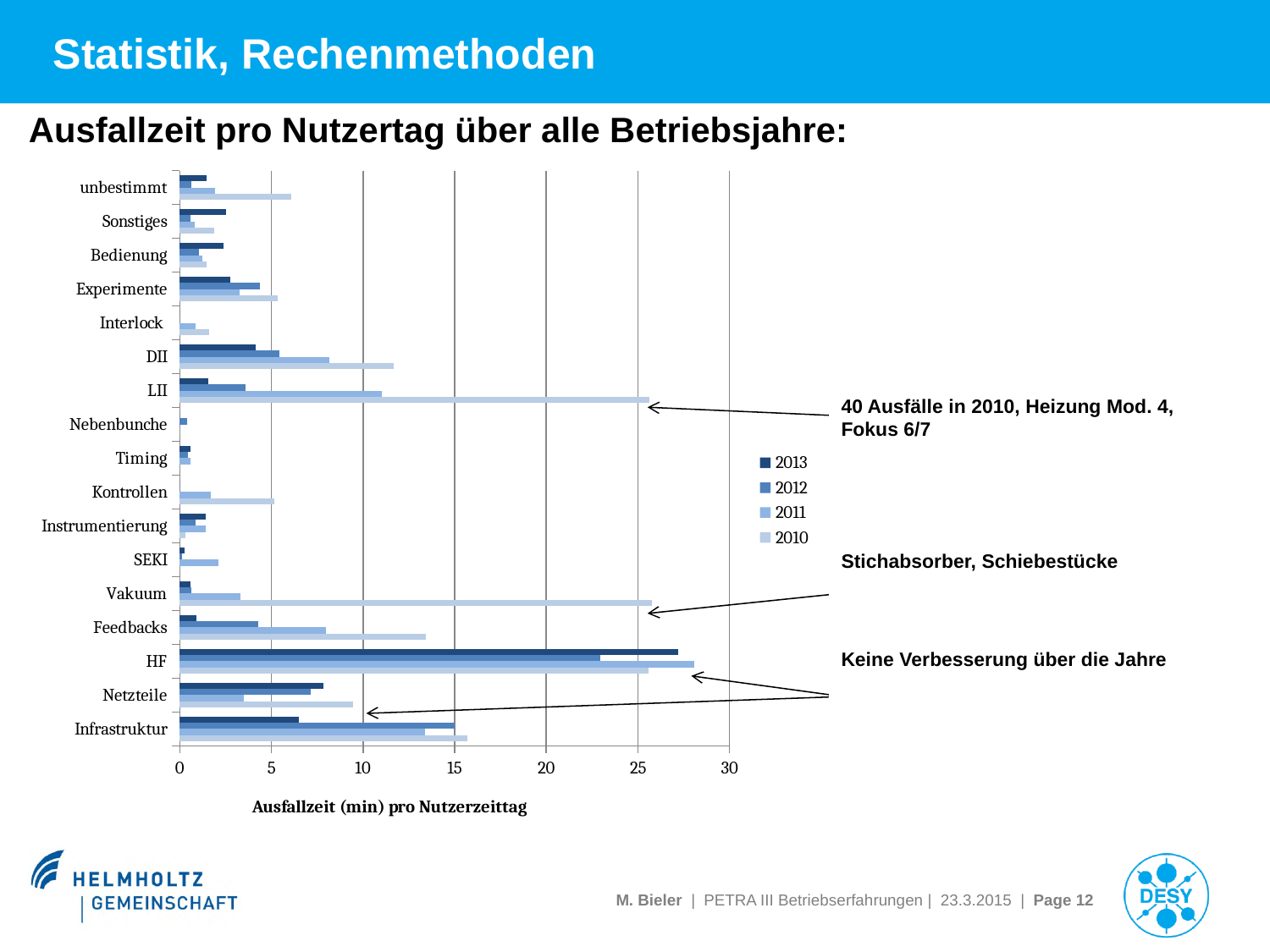
Is the 2013 value for HF greater or less than 25? greater What kind of chart is shown on the slide? bar chart Which is larger, the 2013 value for HF or the 2013 value for Netzteile? HF Which years are listed in the chart legend? 2013, 2012, 2011, 2010 For Feedbacks, which is larger, the 2010 value or the 2013 value? 2010 Which category has the longest bar for 2012? HF What is the label of the horizontal axis of the chart? Ausfallzeit (min) pro Nutzerzeittag How many series does the chart legend list? 4 Which category has the longest bar for 2013? HF Is the 2010 value for DII greater or less than 10? greater How many categories are listed on the vertical axis of the chart? 17 Is the 2010 value for Feedbacks greater or less than 15? less